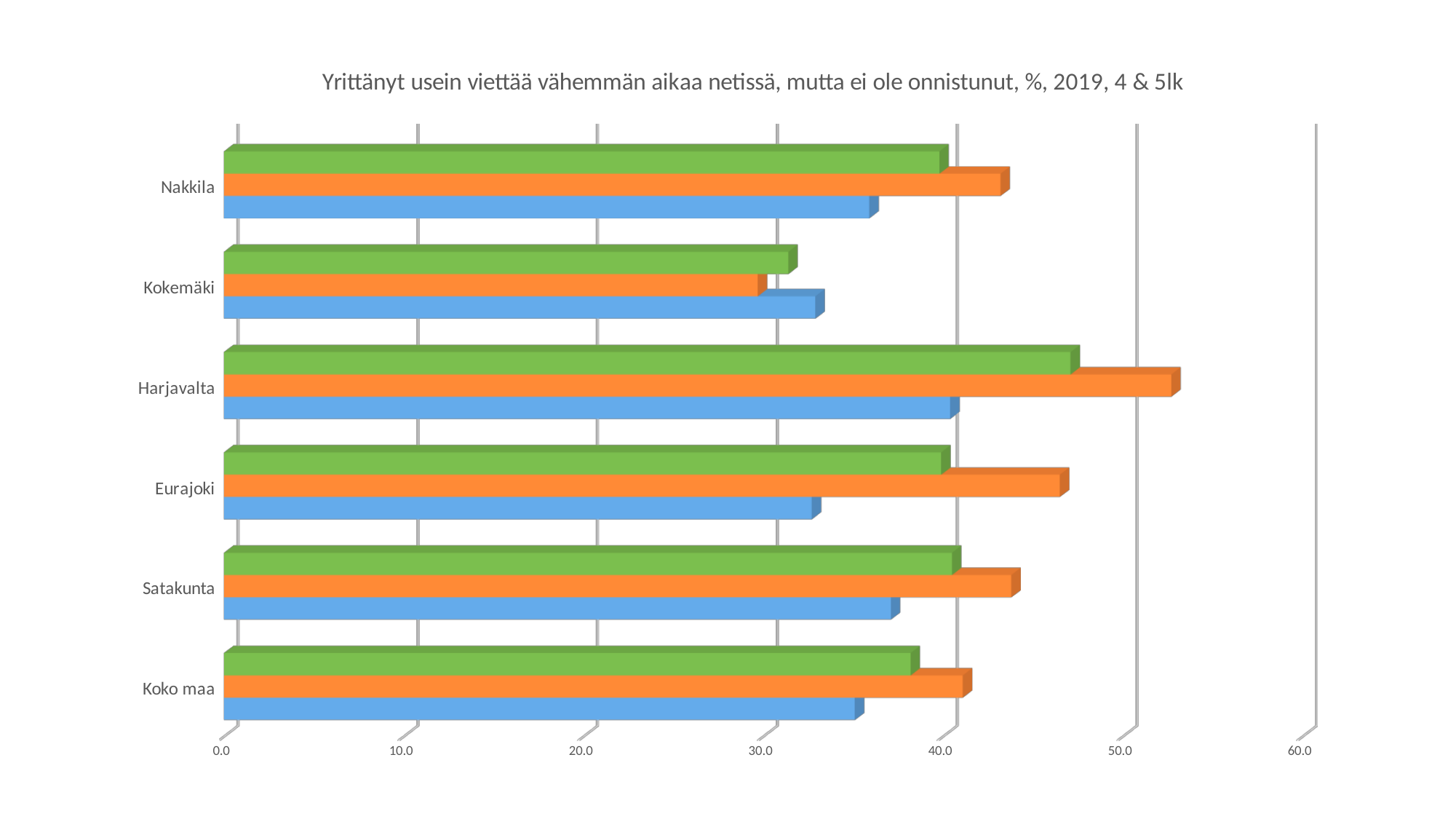
Is the orange bar for Harjavalta greater or less than 50.0? greater Which area has the longest orange bar? Harjavalta For Eurajoki, which is longer: the orange bar or the blue bar? the orange bar What is the title of the chart? Yrittänyt usein viettää vähemmän aikaa netissä, mutta ei ole onnistunut, %, 2019, 4 & 5lk Is the blue bar for Koko maa greater or less than 40.0? less Which area has the shortest green bar? Kokemäki How many bars are plotted for each area in the chart? 3 What kind of chart is shown on the slide? bar chart How many categories (areas) are shown on the vertical axis of the chart? 6 Which area has the shortest orange bar? Kokemäki Which area has the longest green bar? Harjavalta